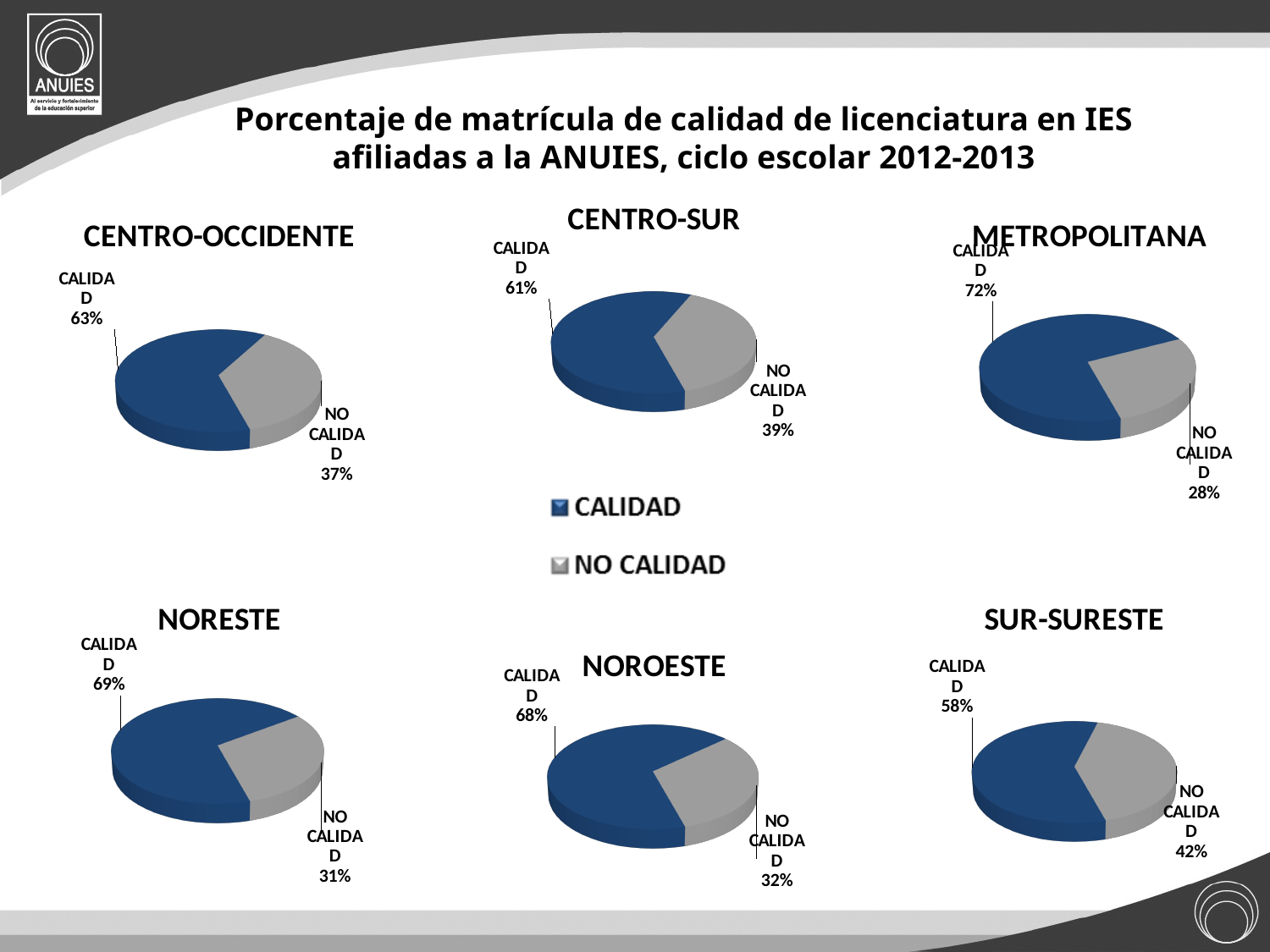
Which colour represents CALIDAD in the legend? Blue How many entries does the shared legend in the middle of the slide list? 2 In the NOROESTE pie chart, what percentage is labelled CALIDAD? 68% What kind of chart is used for the NORESTE region on this slide? Pie chart In the CENTRO-OCCIDENTE pie chart, what percentage is labelled CALIDAD? 63% In the SUR-SURESTE pie chart, which slice is larger, CALIDAD or NO CALIDAD? CALIDAD In the SUR-SURESTE pie chart, what share of the pie is NO CALIDAD? 42% In the METROPOLITANA pie chart, what is the difference between the CALIDAD and NO CALIDAD percentages? 44% In the CENTRO-SUR pie chart, what percentage is labelled NO CALIDAD? 39% In the NORESTE pie chart, what percentage is labelled NO CALIDAD? 31% How many slices does the CENTRO-SUR pie chart have? 2 In the METROPOLITANA pie chart, what share of the pie is CALIDAD? 72%